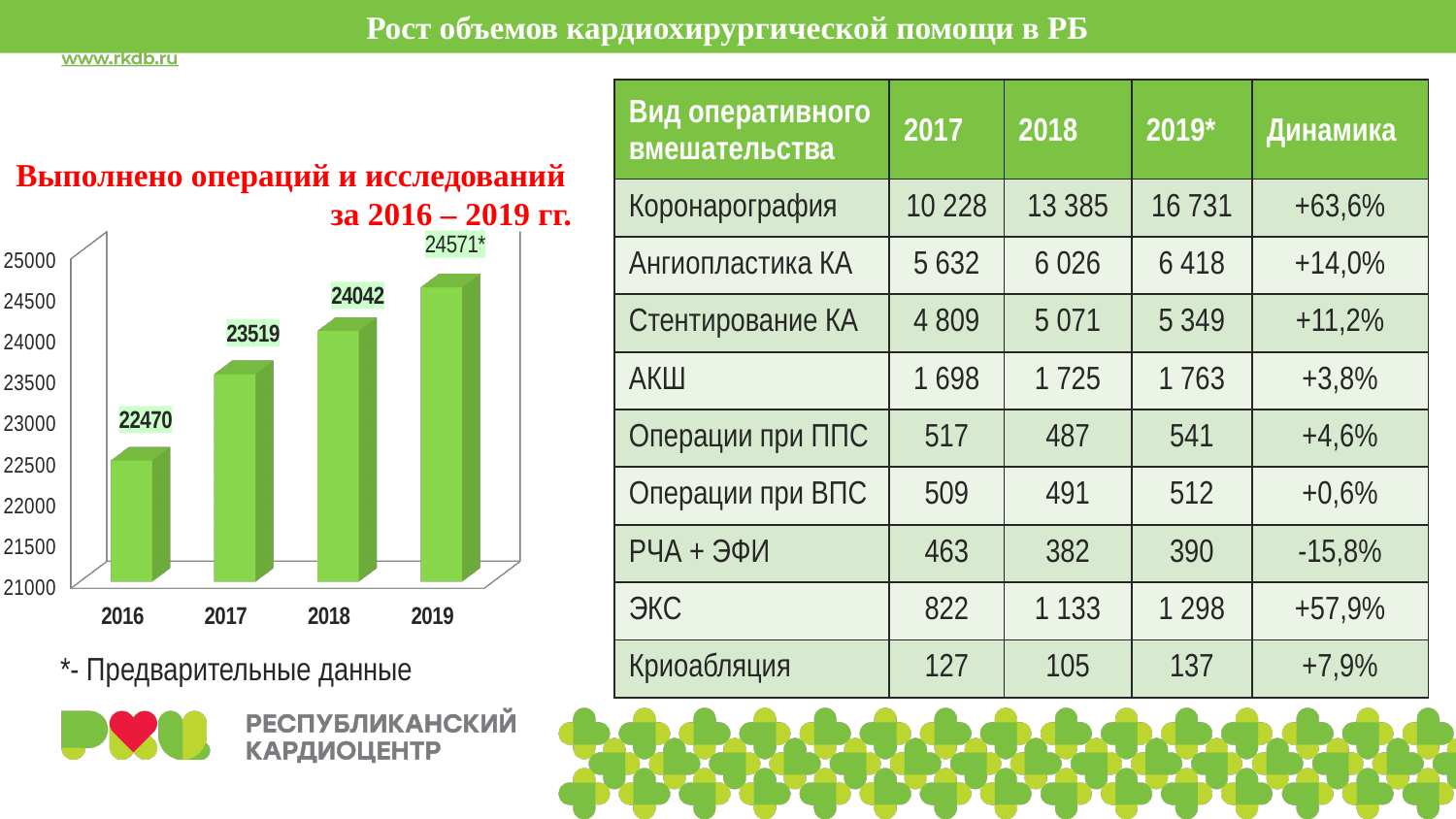
What value does the chart show for 2019? 24571 Do the values in the chart rise or fall from 2016 to 2019? rise How many years (categories) are shown in the chart? 4 Which is larger in the chart, the value for 2018 or the value for 2017? 2018 Which year has the lowest value in the chart? 2016 What value does the chart show for 2018? 24042 What is the difference between the values for 2019 and 2018 in the chart? 529 What value does the chart show for 2017? 23519 What type of chart is shown on the slide? bar chart What value does the chart show for 2016? 22470 What is the difference between the values for 2017 and 2016 in the chart? 1049 Which year has the highest value in the chart? 2019